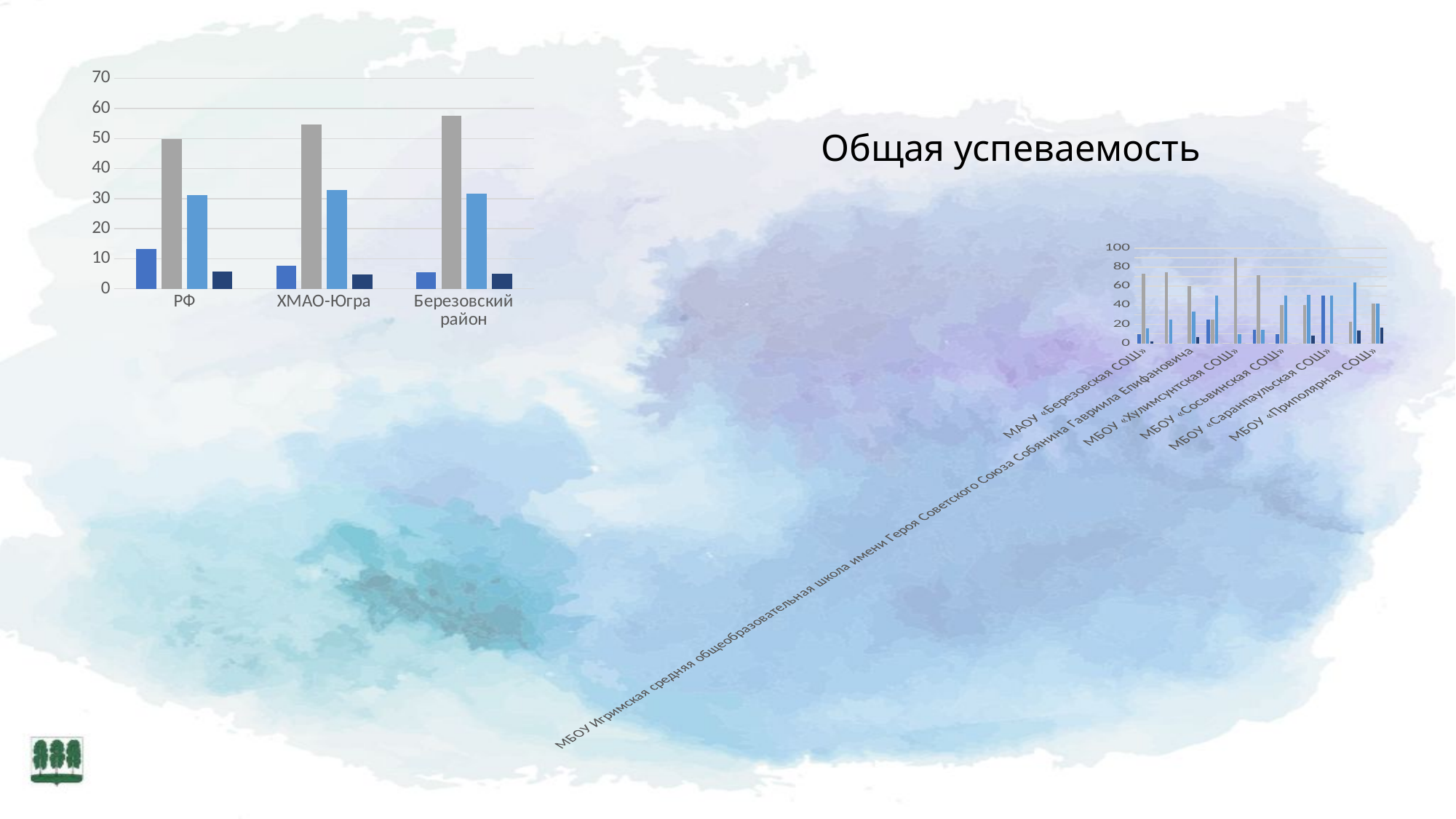
In the left chart, is the value of the gray bar for Березовский район greater or less than 50? greater In the left chart, is the value of the first (dark blue) bar for РФ greater or less than 10? greater In the left chart, which is larger: the gray bar for ХМАО-Югра or the gray bar for РФ? ХМАО-Югра How many categories are shown on the x axis of the left chart? 3 What is the highest value shown on the y axis of the right chart? 100 In the left chart, is the value of the first (dark blue) bar for Березовский район greater or less than 10? less In the left chart, which category has the tallest first (dark blue) bar? РФ What kind of chart is the chart on the left of the slide? bar chart How many bars are plotted for each category in the left chart? 4 What title is written on the slide above the right chart? Общая успеваемость